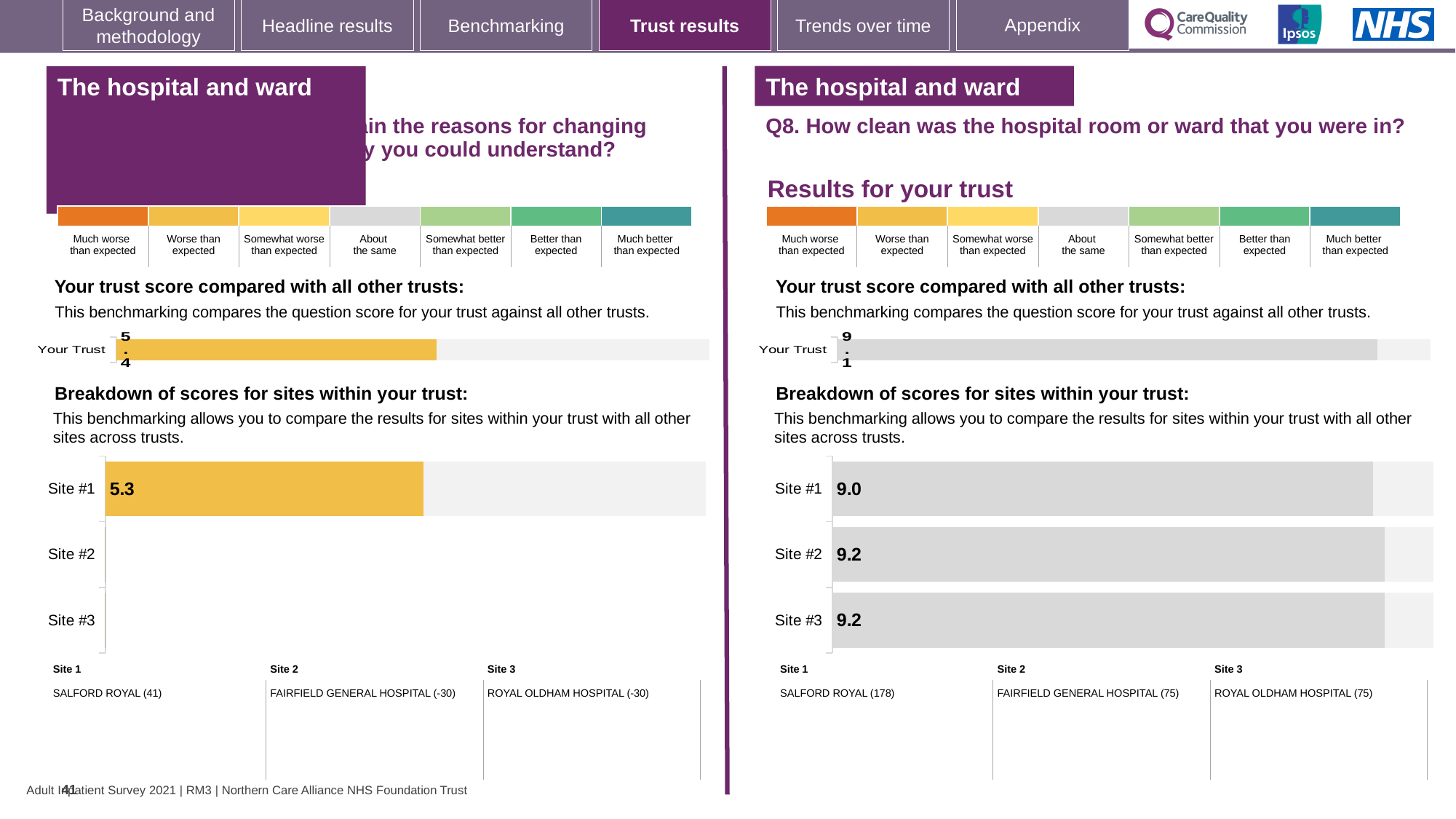
On the right-hand (Q8) 'Your trust score compared with all other trusts' chart, what is the score for Your Trust? 9.1 On the left-hand 'Your trust score compared with all other trusts' chart, what is the score for Your Trust? 5.4 On the left-hand site breakdown chart, what is the score for Site #1? 5.3 On the right-hand (Q8) site breakdown chart, what is the difference between the scores for Site #2 and Site #1? 0.2 On the left-hand site breakdown chart, which benchmark category does the colour of the Site #1 bar correspond to? Worse than expected On the right-hand (Q8) 'Breakdown of scores for sites within your trust' chart, what is the score for Site #1? 9.0 On the right-hand (Q8) site breakdown chart, what is the score for Site #2? 9.2 Which is higher: the Your Trust score on the left-hand chart or the Your Trust score on the right-hand (Q8) chart? the right-hand (Q8) chart On the right-hand (Q8) site breakdown chart, which site has the lowest score? Site #1 On the right-hand (Q8) site breakdown chart, what is the score for Site #3? 9.2 What type of chart is used for the site breakdown on the right-hand (Q8) side of the slide? bar chart How many sites are listed on the right-hand (Q8) site breakdown chart? 3